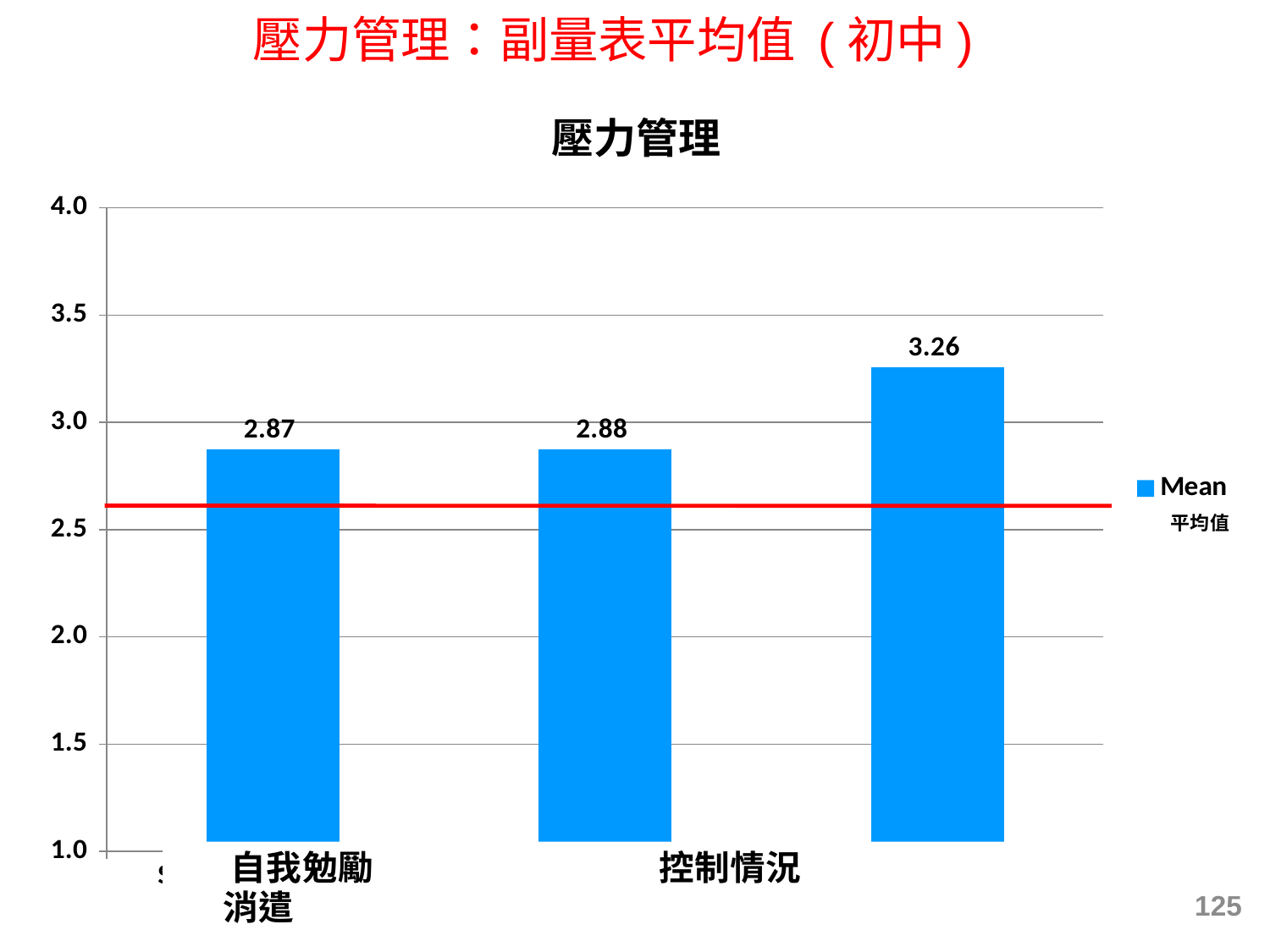
What is the difference between the rightmost bar (3.26) and the 控制情況 bar (2.88)? 0.38 What kind of chart is shown on the slide? bar chart Which bar has the highest value in the 壓力管理 chart? the rightmost bar (3.26) Which is larger, the value of the rightmost bar or the value of the 控制情況 bar? the rightmost bar What is the difference between the rightmost bar (3.26) and the leftmost bar (2.87)? 0.39 What is the value shown on the rightmost bar of the 壓力管理 chart? 3.26 What is the legend entry for the blue bars? Mean What is the value shown on the bar labelled 控制情況? 2.88 Is the value of the rightmost bar greater or less than 3.0? greater How many series does the legend list? 1 What is the value shown on the leftmost bar of the 壓力管理 chart? 2.87 How many bars are plotted in the 壓力管理 chart? 3